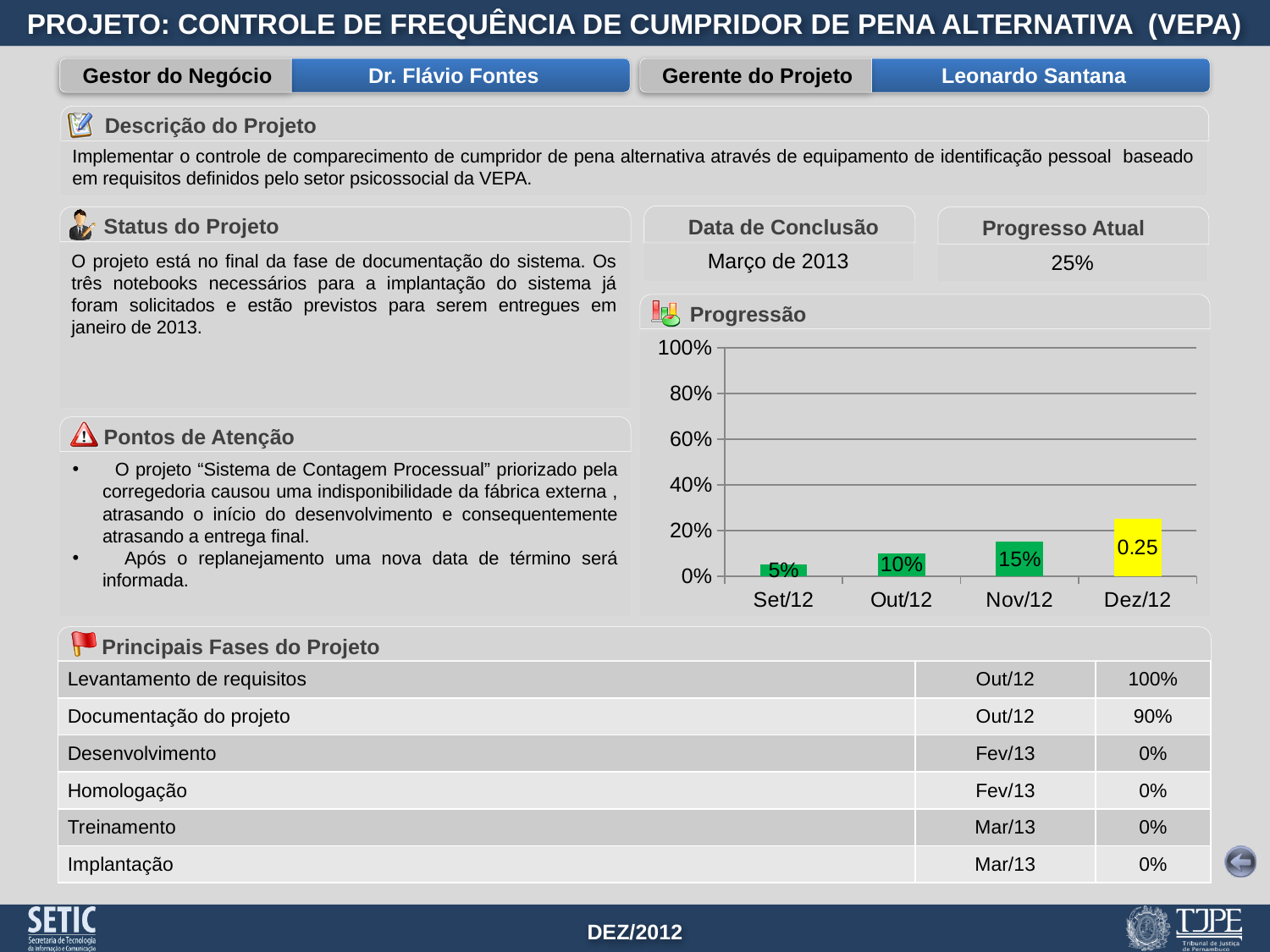
What is the value for Set/12 in the Progressão chart? 5% Which is larger in the Progressão chart, the value for Out/12 or the value for Set/12? Out/12 What kind of chart is the Progressão chart? bar chart What data label is shown on the Dez/12 bar in the Progressão chart? 0.25 Which month has the lowest value in the Progressão chart? Set/12 Do the values in the Progressão chart rise or fall from Set/12 to Dez/12? rise How many months are plotted in the Progressão chart? 4 Which month has the highest value in the Progressão chart? Dez/12 What is the value for Nov/12 in the Progressão chart? 15% What is the value for Out/12 in the Progressão chart? 10% Is the value for Nov/12 in the Progressão chart greater or less than 20%? less What is the difference between the Nov/12 and Out/12 values in the Progressão chart? 5%